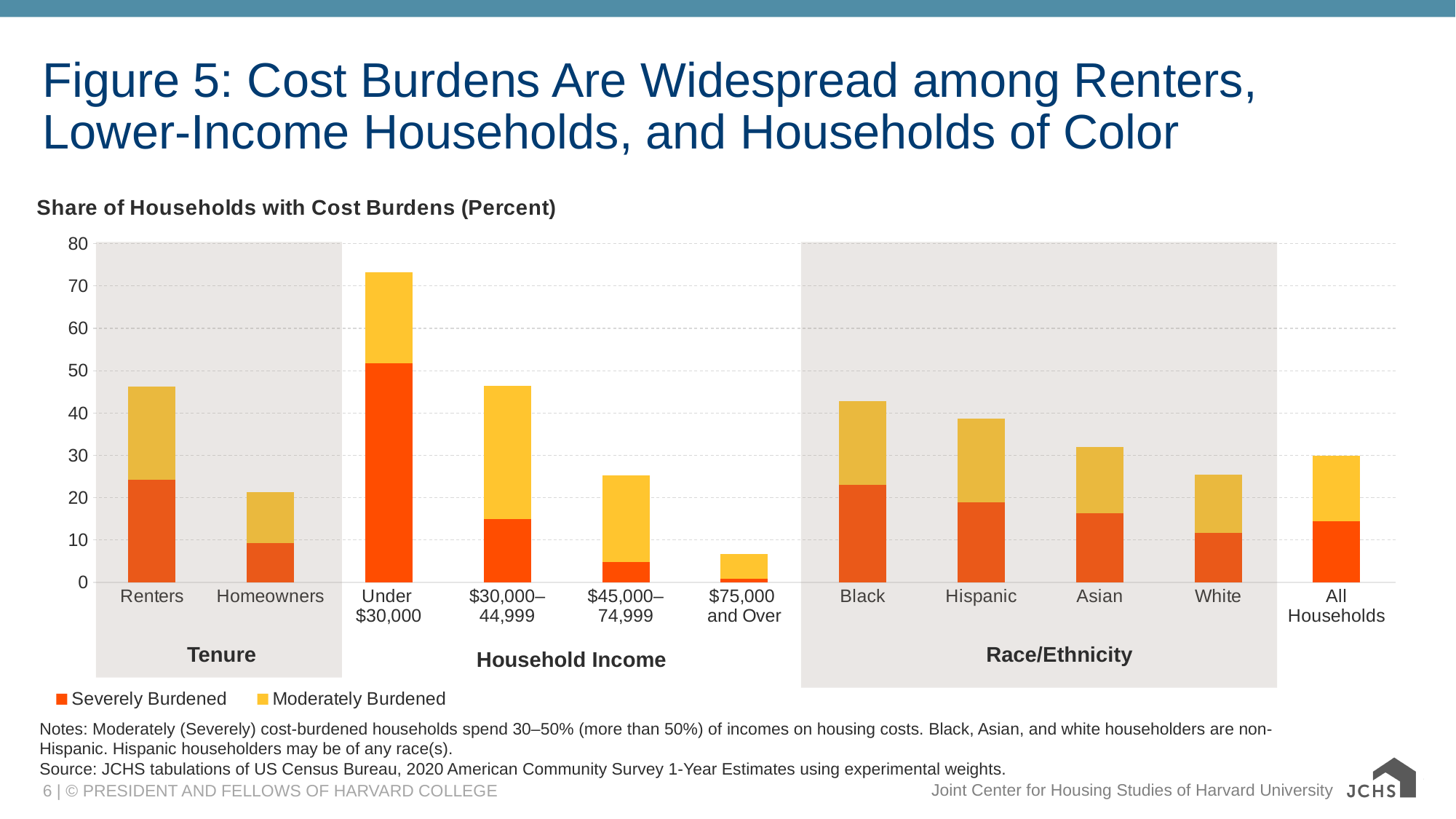
Which category has the highest total share of households with cost burdens? Under $30,000 Is the total value for Under $30,000 greater or less than 70? greater Which has a larger total share of cost-burdened households, Renters or Homeowners? Renters Across the Household Income groups, do the total cost-burden shares rise or fall as income increases? fall Is the total value for Hispanic households greater or less than 40? less Which legend entry is shown in the orange-red colour? Severely Burdened Which has a larger total share of cost-burdened households, Black or White households? Black What kind of chart is shown on the slide? Stacked bar chart Which category has the lowest total share of households with cost burdens? $75,000 and Over How many categories are plotted along the x axis? 11 Is the total value for Renters greater or less than 40? greater How many series does the legend list? 2